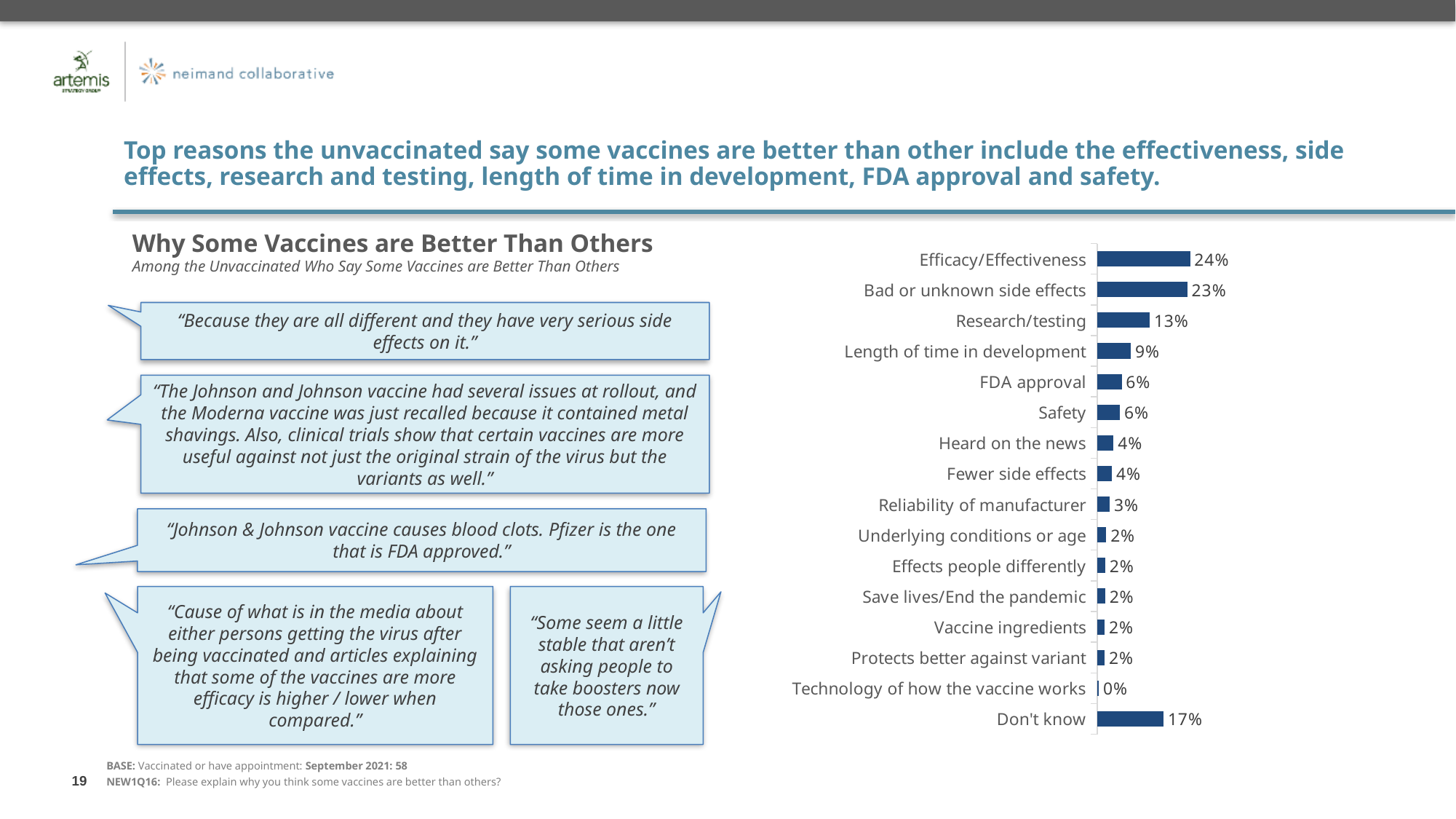
What percentage is shown for Don't know? 17% How many reason categories are plotted in the chart? 16 What is the value for Length of time in development? 9% Which is larger, the value for Don't know or the value for Research/testing? Don't know What is the difference between the percentages for Research/testing and Length of time in development? 4% What type of chart is used to show the reasons? Bar chart What is the title of the chart? Why Some Vaccines are Better Than Others What is the value shown for Research/testing? 13% What percentage of respondents cited Efficacy/Effectiveness as a reason some vaccines are better than others? 24% What is the difference between the percentages for Efficacy/Effectiveness and Bad or unknown side effects? 1% Which reason has the highest percentage in the chart? Efficacy/Effectiveness Which reason has the lowest percentage in the chart? Technology of how the vaccine works